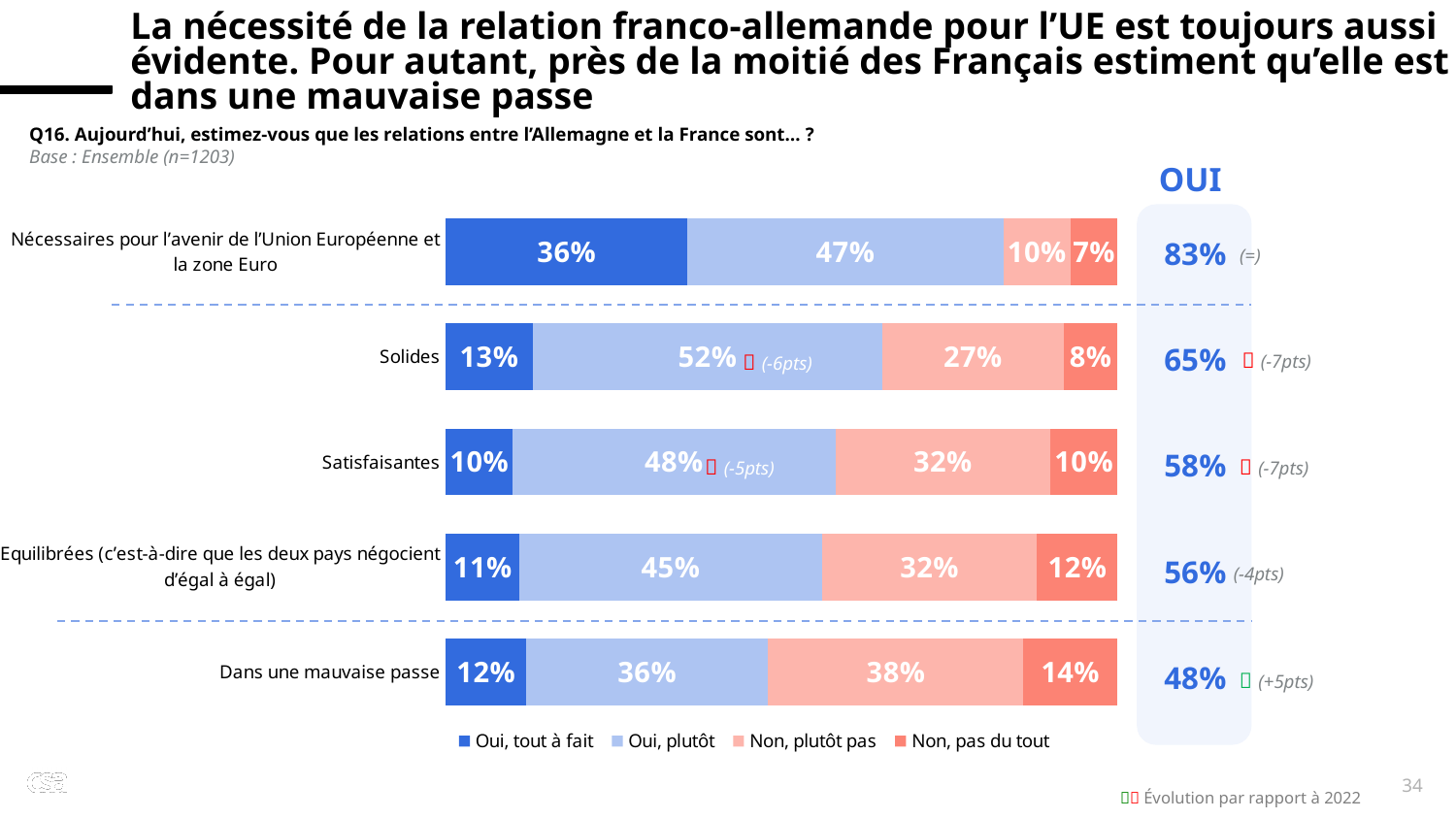
Which category has the highest "Oui, tout à fait" percentage? Nécessaires pour l'avenir de l'Union Européenne et la zone Euro What is the difference in percentage points between the "Non, plutôt pas" values for "Dans une mauvaise passe" and "Solides"? 11 points Which category has the highest "Non, pas du tout" percentage? Dans une mauvaise passe What kind of chart is shown on the slide? Stacked bar chart What percentage answered "Non, plutôt pas" for "Dans une mauvaise passe"? 38% What percentage answered "Oui, plutôt" for "Solides"? 52% How many categories (statements) are shown in the chart? 5 What percentage answered "Oui, tout à fait" for "Nécessaires pour l'avenir de l'Union Européenne et la zone Euro"? 36% What is the combined "Oui" total (Oui, tout à fait + Oui, plutôt) for "Solides"? 65% Which has a larger "Oui, plutôt" percentage: "Satisfaisantes" or "Equilibrées"? Satisfaisantes Which category has the lowest "Non, pas du tout" percentage? Nécessaires pour l'avenir de l'Union Européenne et la zone Euro How many series does the legend list? 4